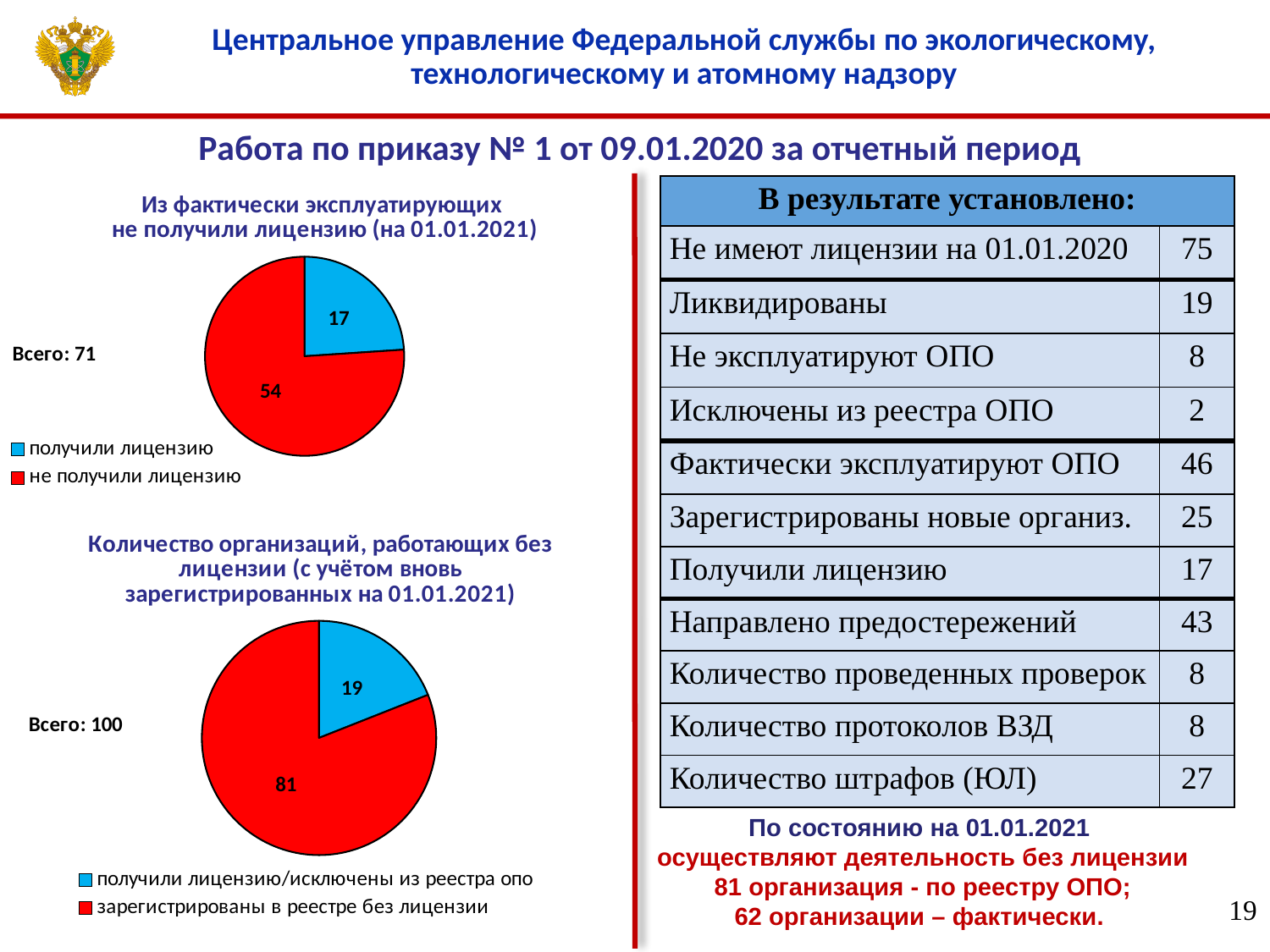
What type of chart is used for 'Количество организаций, работающих без лицензии'? Pie chart In the bottom pie chart, what share of the total does 'зарегистрированы в реестре без лицензии' represent? 81% In the bottom pie chart, which category has the smallest slice? получили лицензию/исключены из реестра опо In the bottom pie chart 'Количество организаций, работающих без лицензии', what is the value for 'зарегистрированы в реестре без лицензии'? 81 How many slices does the top pie chart have? 2 In the top pie chart 'Из фактически эксплуатирующих не получили лицензию (на 01.01.2021)', what is the value for 'получили лицензию'? 17 In the top pie chart, which category has the largest slice? не получили лицензию In the top pie chart 'Из фактически эксплуатирующих не получили лицензию (на 01.01.2021)', what is the value for 'не получили лицензию'? 54 What total ('Всего') is shown next to the bottom pie chart? Всего: 100 In the top pie chart, what is the difference between 'не получили лицензию' and 'получили лицензию'? 37 In the bottom pie chart 'Количество организаций, работающих без лицензии', what is the value for 'получили лицензию/исключены из реестра опо'? 19